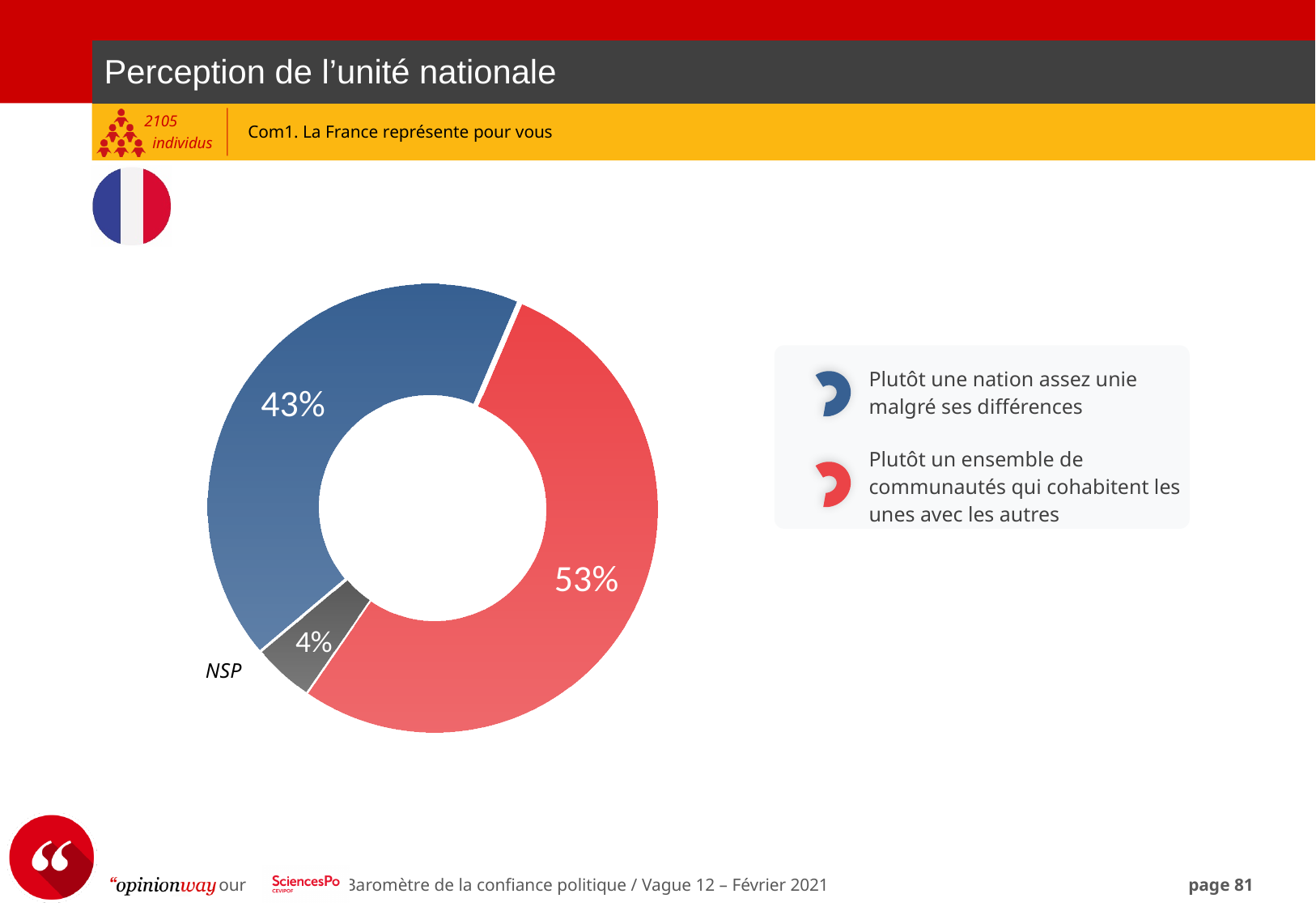
Which response has the smallest share of the pie? NSP What kind of chart is shown on the slide? Pie chart (donut) What is the combined share of the two non-NSP responses? 96% What percentage of respondents answered NSP? 4% What is the difference in percentage points between the "ensemble de communautés" response and the "nation assez unie" response? 10 points How many slices does the pie chart have? 3 What colour is the slice representing "Plutôt un ensemble de communautés qui cohabitent les unes avec les autres"? Red Which response has the largest share of the pie? Plutôt un ensemble de communautés qui cohabitent les unes avec les autres What colour is the slice representing "Plutôt une nation assez unie malgré ses différences"? Blue Which is larger: the share for "Plutôt une nation assez unie" or the share for "Plutôt un ensemble de communautés"? Plutôt un ensemble de communautés What percentage of respondents chose "Plutôt une nation assez unie malgré ses différences"? 43% What percentage of respondents chose "Plutôt un ensemble de communautés qui cohabitent les unes avec les autres"? 53%